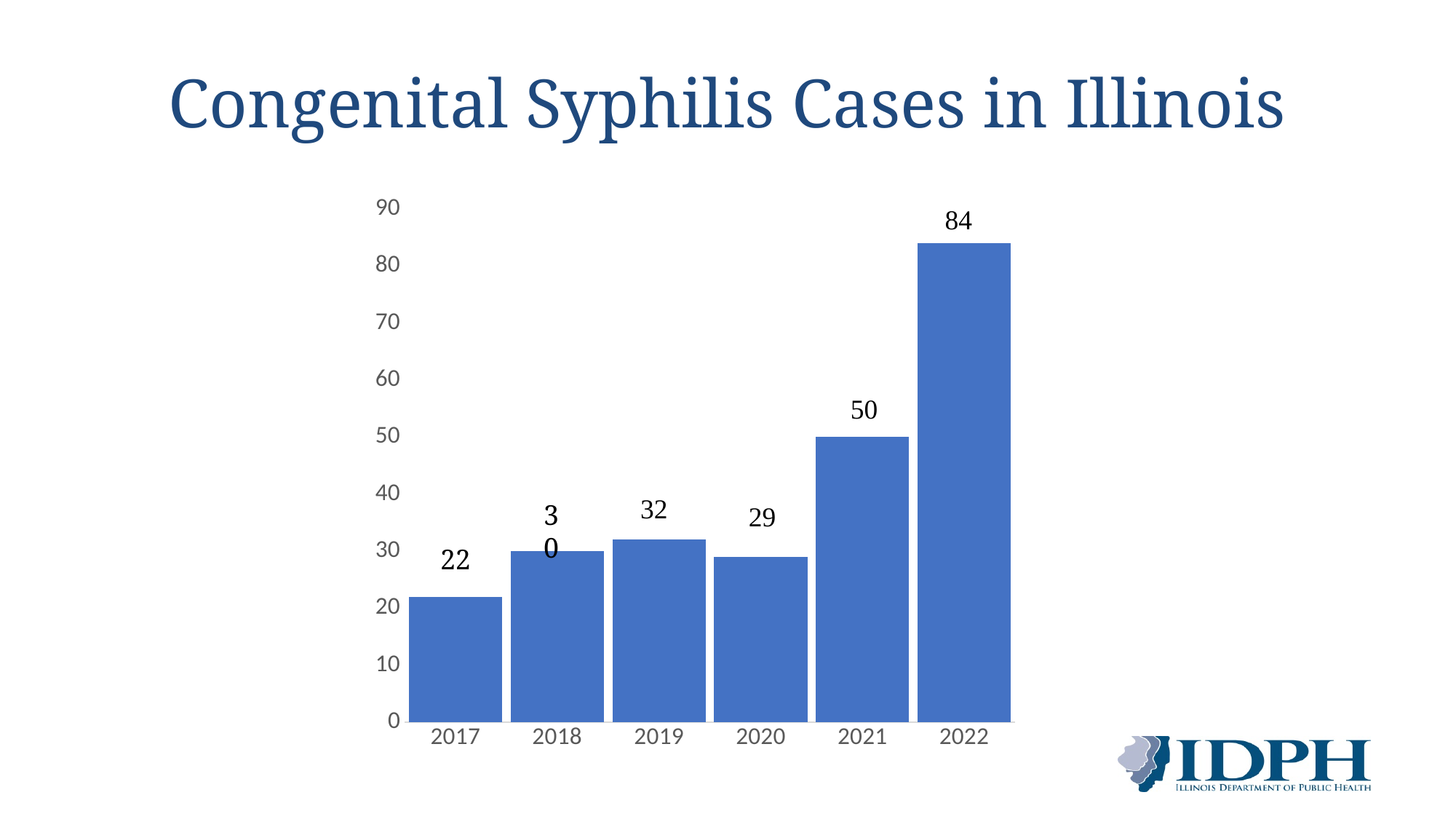
What is the difference between the 2019 and 2020 values? 3 Which year has the highest number of cases? 2022 How many years are shown on the x axis? 6 What kind of chart is shown on the slide? Bar chart What is the value shown for 2021? 50 What is the difference between the 2022 and 2021 values? 34 Which year has more cases, 2019 or 2020? 2019 What is the value shown for 2020? 29 What is the value shown for 2017? 22 How many congenital syphilis cases were reported in Illinois in 2022? 84 Which year has the lowest number of cases? 2017 What is the title of the slide? Congenital Syphilis Cases in Illinois